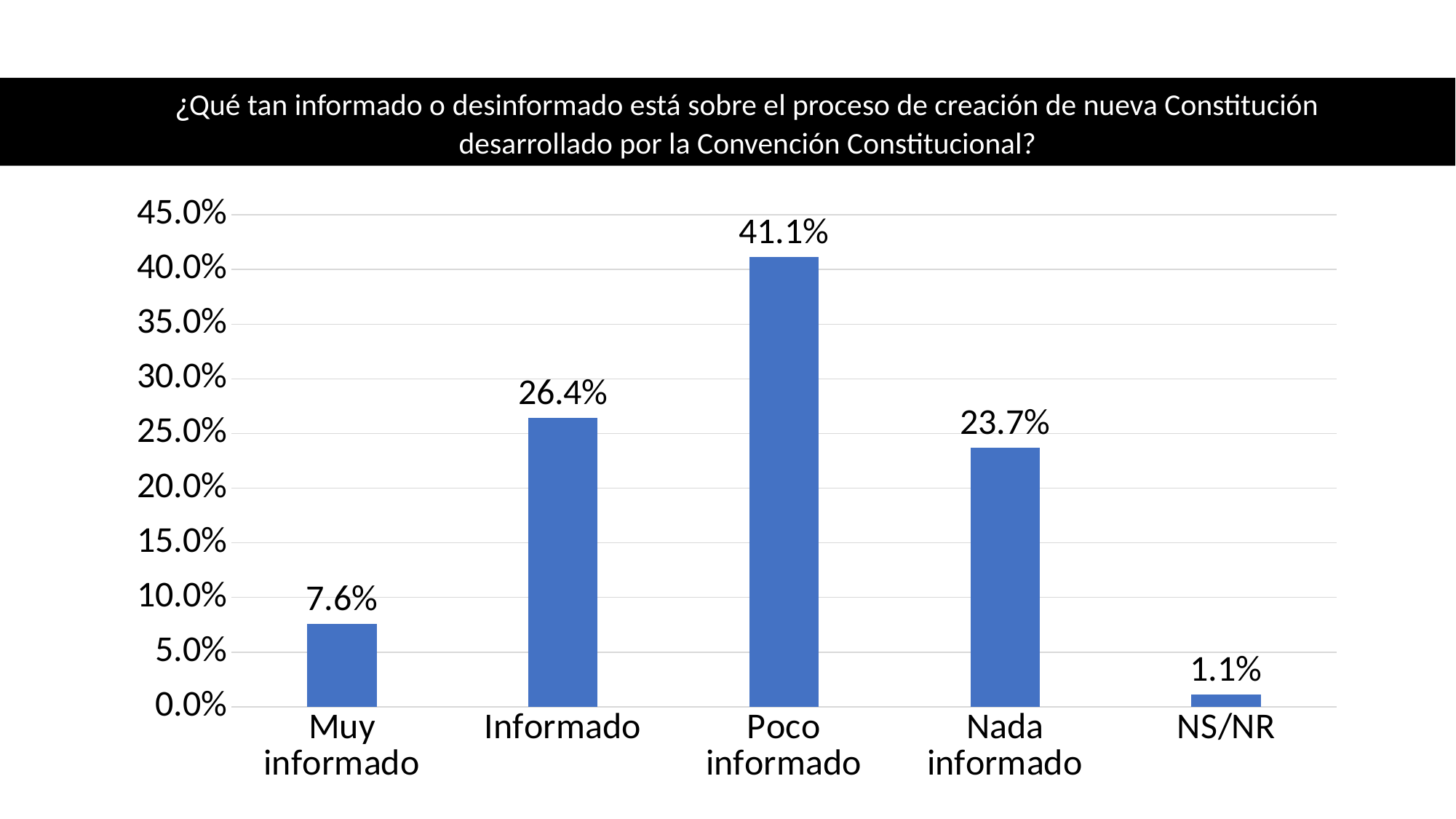
Is the value for "Poco informado" greater or less than 40.0%? greater Which category has the lowest value? NS/NR Which is larger, the value for "Informado" or the value for "Nada informado"? Informado What is the value for "Muy informado"? 7.6% What is the highest value shown on the vertical axis? 45.0% How many categories are shown on the x axis? 5 What is the value for "NS/NR"? 1.1% Which category has the highest value? Poco informado What is the value for "Poco informado"? 41.1% What is the difference between the values for "Informado" and "Nada informado"? 2.7% What is the difference between the values for "Poco informado" and "Muy informado"? 33.5% What kind of chart is shown on the slide? Bar chart